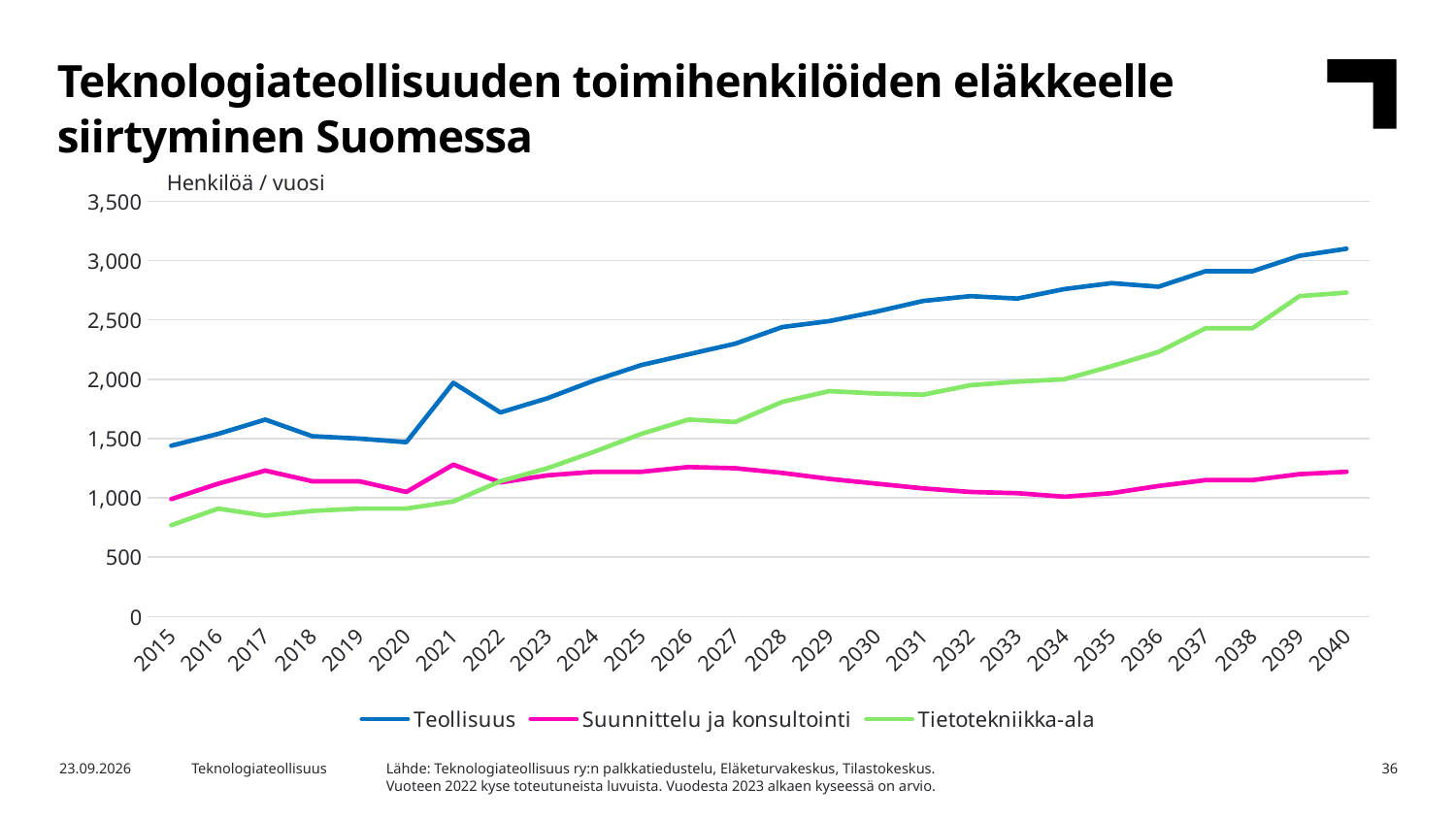
Is the value for Teollisuus in 2040 greater or less than 3,000? greater In 2040, which is larger: Suunnittelu ja konsultointi or Tietotekniikka-ala? Tietotekniikka-ala How many years are shown on the x axis? 26 What is the label shown above the vertical axis? Henkilöä / vuosi In 2015, which is larger: Suunnittelu ja konsultointi or Tietotekniikka-ala? Suunnittelu ja konsultointi Which series has the highest value in 2040? Teollisuus Which series has the lowest value in 2040? Suunnittelu ja konsultointi Does the Tietotekniikka-ala series generally rise or fall from 2015 to 2040? Rise Is the value for Tietotekniikka-ala in 2015 greater or less than 1,000? less Is the value for Tietotekniikka-ala in 2040 greater or less than 2,500? greater How many series does the legend list? 3 What kind of chart is shown on the slide? Line chart